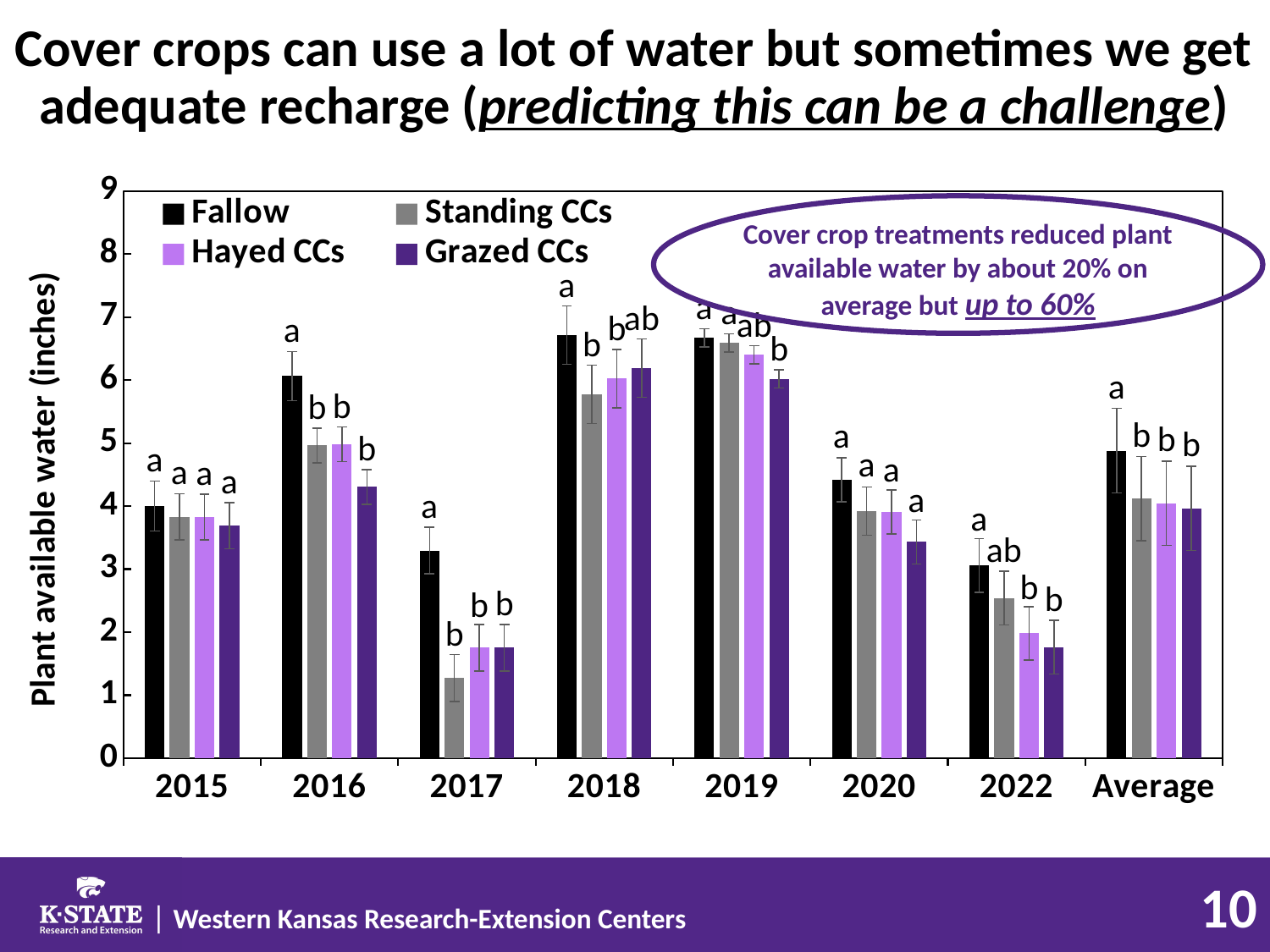
Is the value for Fallow in 2018 greater or less than 6? greater Is the value for Standing CCs in 2017 greater or less than 2? less How many categories are shown along the x axis? 8 How many series does the legend list? 4 Which is larger, the Fallow value in 2016 or the Fallow value in 2017? 2016 What is the label of the y axis? Plant available water (inches) Which treatment has the highest plant available water in 2022? Fallow Which treatment has the lowest plant available water in 2017? Standing CCs Is the value for Fallow in 2016 greater or less than 5? greater What kind of chart is shown on the slide? bar chart Does the Fallow value rise or fall from 2016 to 2017? fall